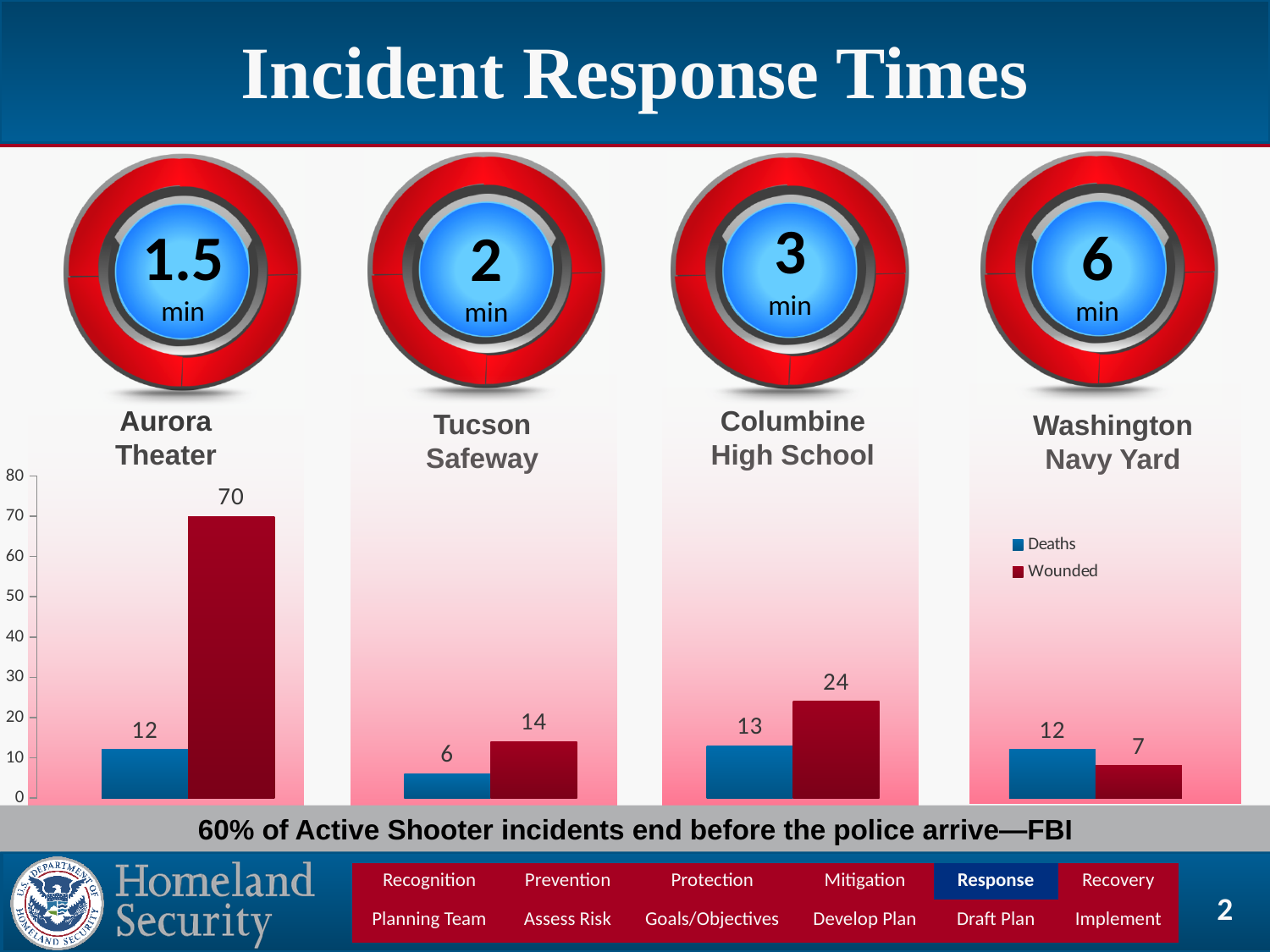
What is the Wounded value for Aurora Theater? 70 Which incident has the lowest Deaths value? Tucson Safeway What is the Deaths value for Tucson Safeway? 6 Which colour represents the Wounded series in the legend? red How many series does the legend list? 2 Which incident has the highest Wounded value? Aurora Theater What is the Wounded value for Washington Navy Yard? 7 How many incidents (categories) are plotted in the bar chart? 4 Is the Wounded value for Aurora Theater greater or less than 60? greater Which is larger for Washington Navy Yard, Deaths or Wounded? Deaths What is the difference between the Wounded and Deaths values for Columbine High School? 11 What kind of chart is shown on the slide? bar chart